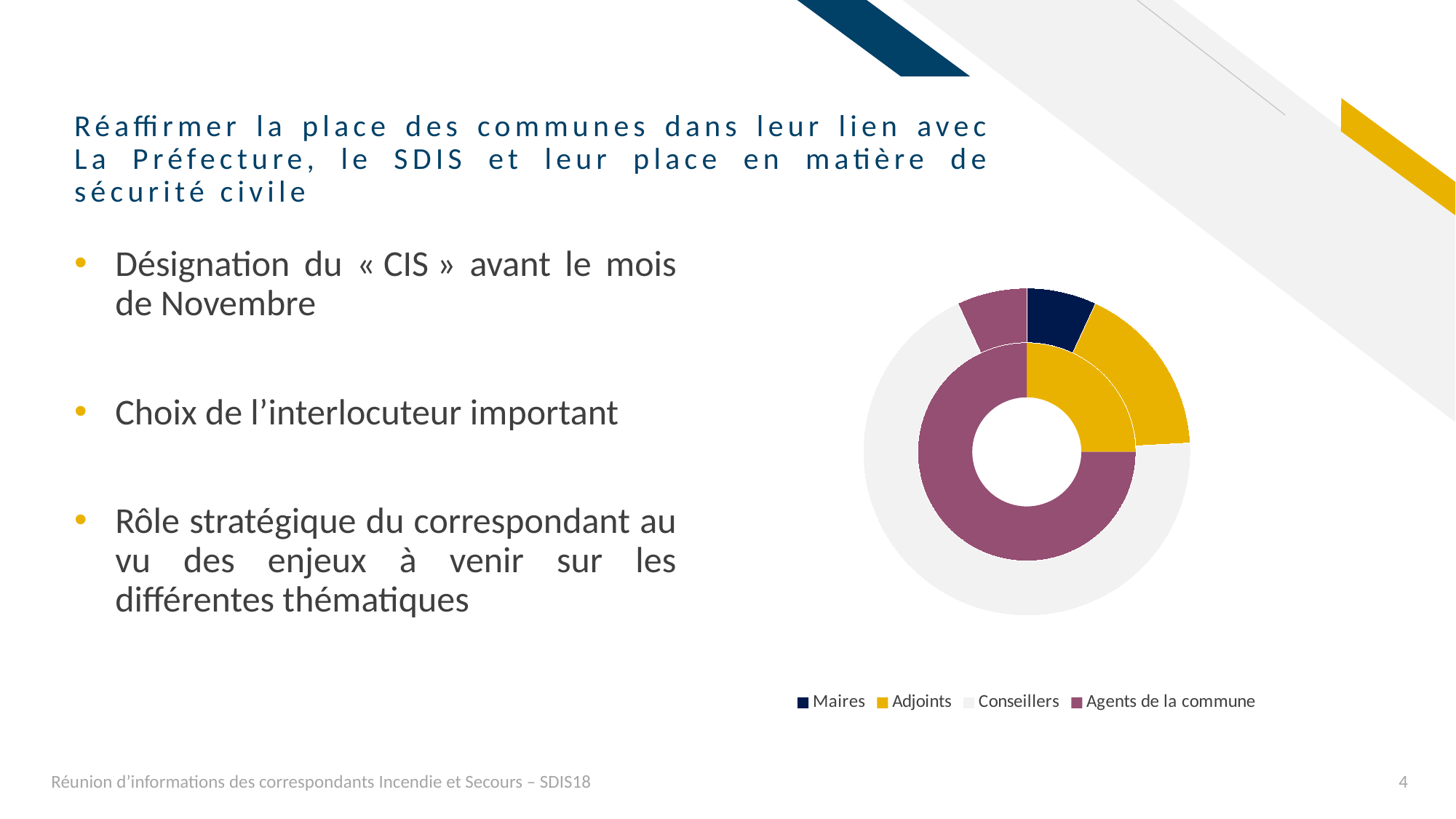
In the outer ring of the doughnut chart, which is larger: the share for Adjoints or the share for Maires? Adjoints In the outer ring of the doughnut chart, which is larger: the share for Conseillers or the share for Agents de la commune? Conseillers How many categories does the legend of the doughnut chart list? 4 Which legend entry of the doughnut chart is shown in yellow? Adjoints How many rings (series) does the doughnut chart have? 2 In the inner ring of the doughnut chart, which category has the largest share? Agents de la commune In the inner ring of the doughnut chart, which is larger: the share for Agents de la commune or the share for Adjoints? Agents de la commune Which colour represents Maires in the doughnut chart? Dark navy blue In the outer ring of the doughnut chart, which category has the largest share? Conseillers What kind of chart is shown on the slide? Doughnut chart